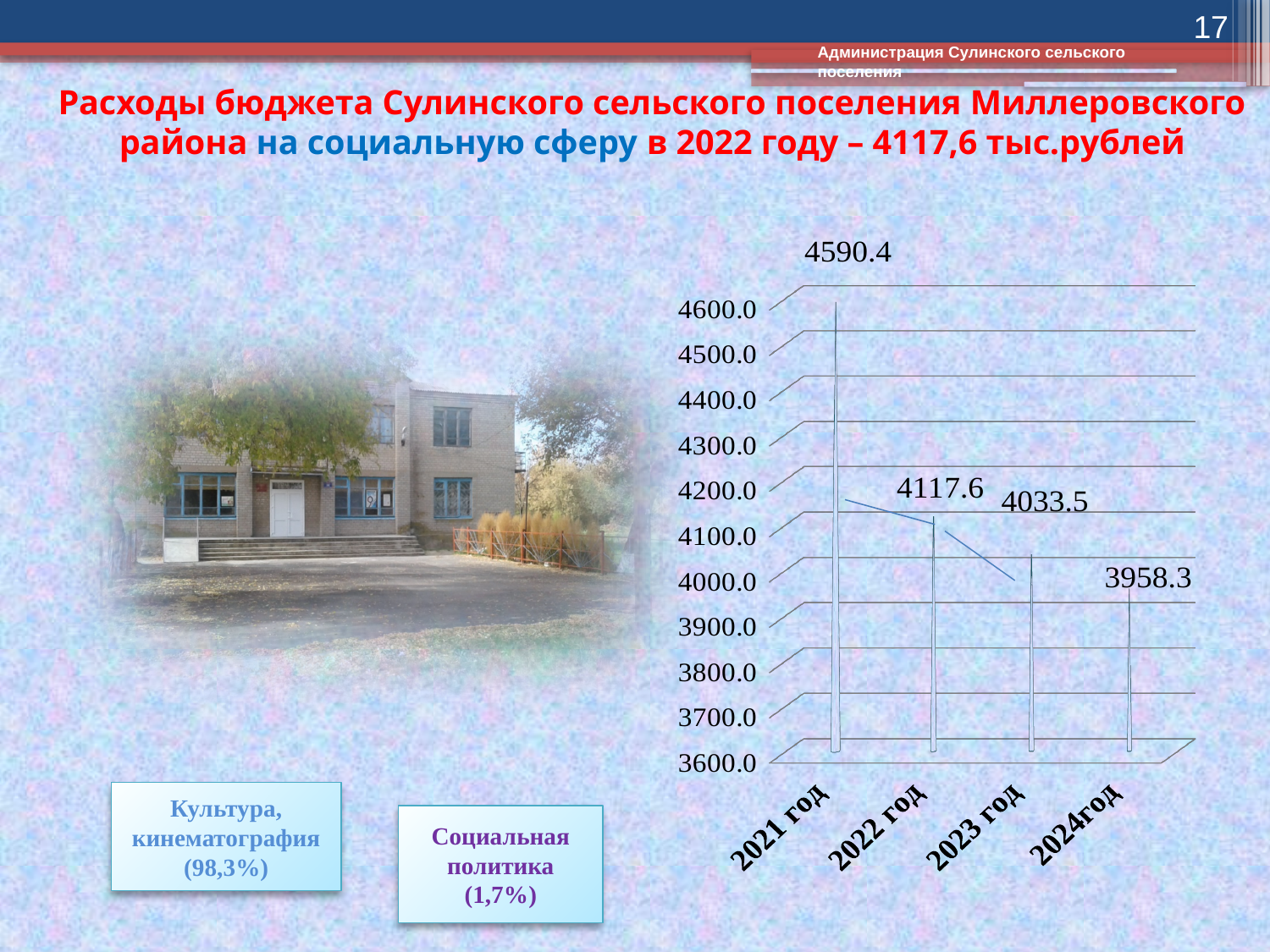
What is the value shown for 2022 год? 4117.6 What is the value shown for 2021 год? 4590.4 Which is larger, the value for 2022 год or the value for 2023 год? 2022 год What kind of chart is shown on the slide? bar chart Which year has the lowest value on the chart? 2024год How many years are plotted on the chart? 4 What is the difference between the values for 2023 год and 2024год? 75.2 Do the values rise or fall from 2021 год to 2024год? fall What is the value shown for 2023 год? 4033.5 What is the difference between the values for 2021 год and 2022 год? 472.8 Which year has the highest value on the chart? 2021 год What is the value shown for 2024год? 3958.3